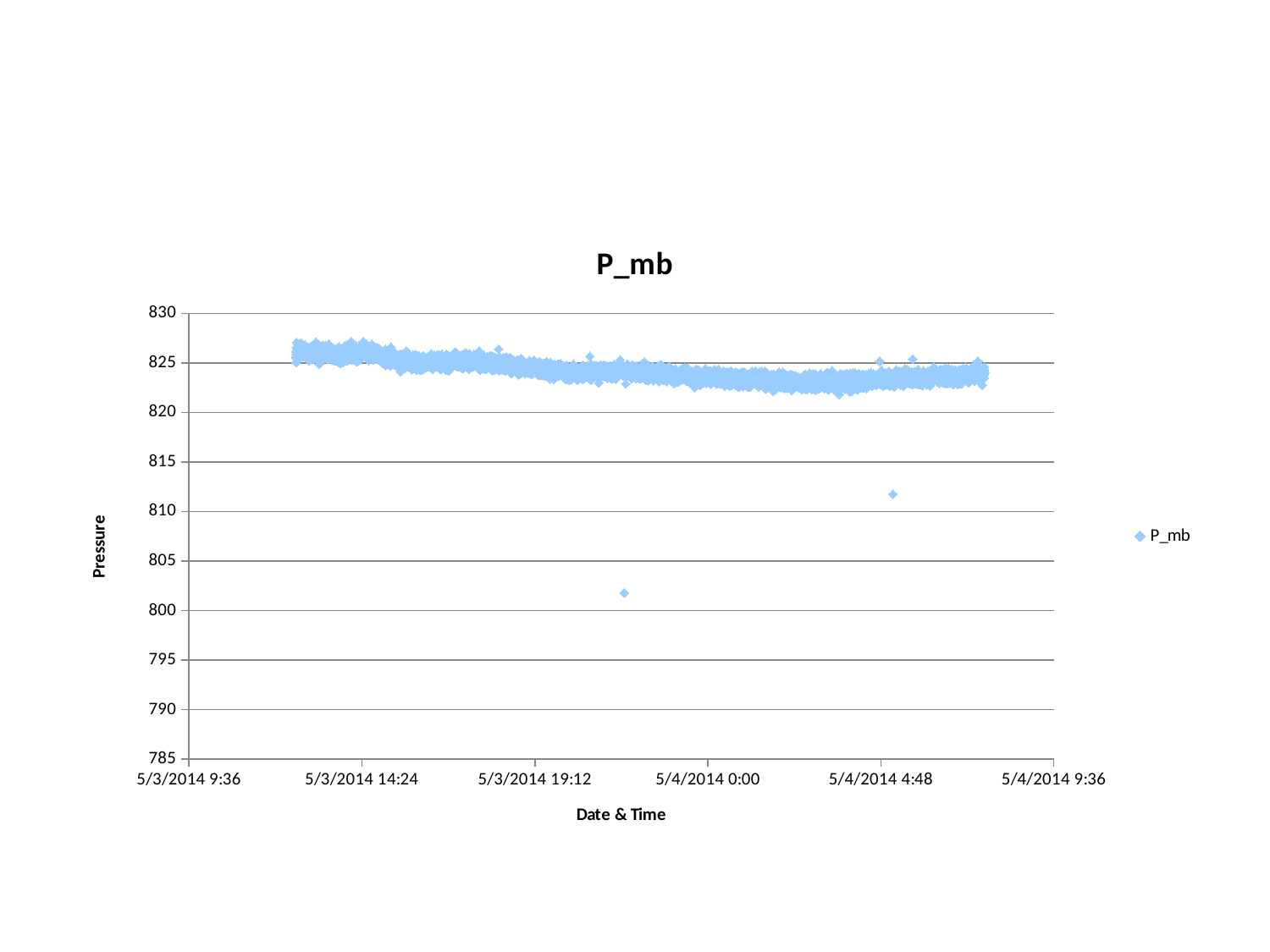
Is the outlier point near 5/4/2014 4:48 greater or less than 815? less What is the title of the chart? P_mb Is the lowest outlier point, near 5/3/2014 21:00, greater or less than 805? less How many series does the legend list? 1 Is the main band of pressure points greater or less than 820? greater Do the pressure values in the main band of points rise or fall along the x axis from 5/3/2014 to 5/4/2014? fall What is the label of the vertical axis? Pressure Which of the two outlier points is lower: the one near 5/3/2014 21:00 or the one near 5/4/2014 4:48? the one near 5/3/2014 21:00 What kind of chart is shown on the slide? scatter chart